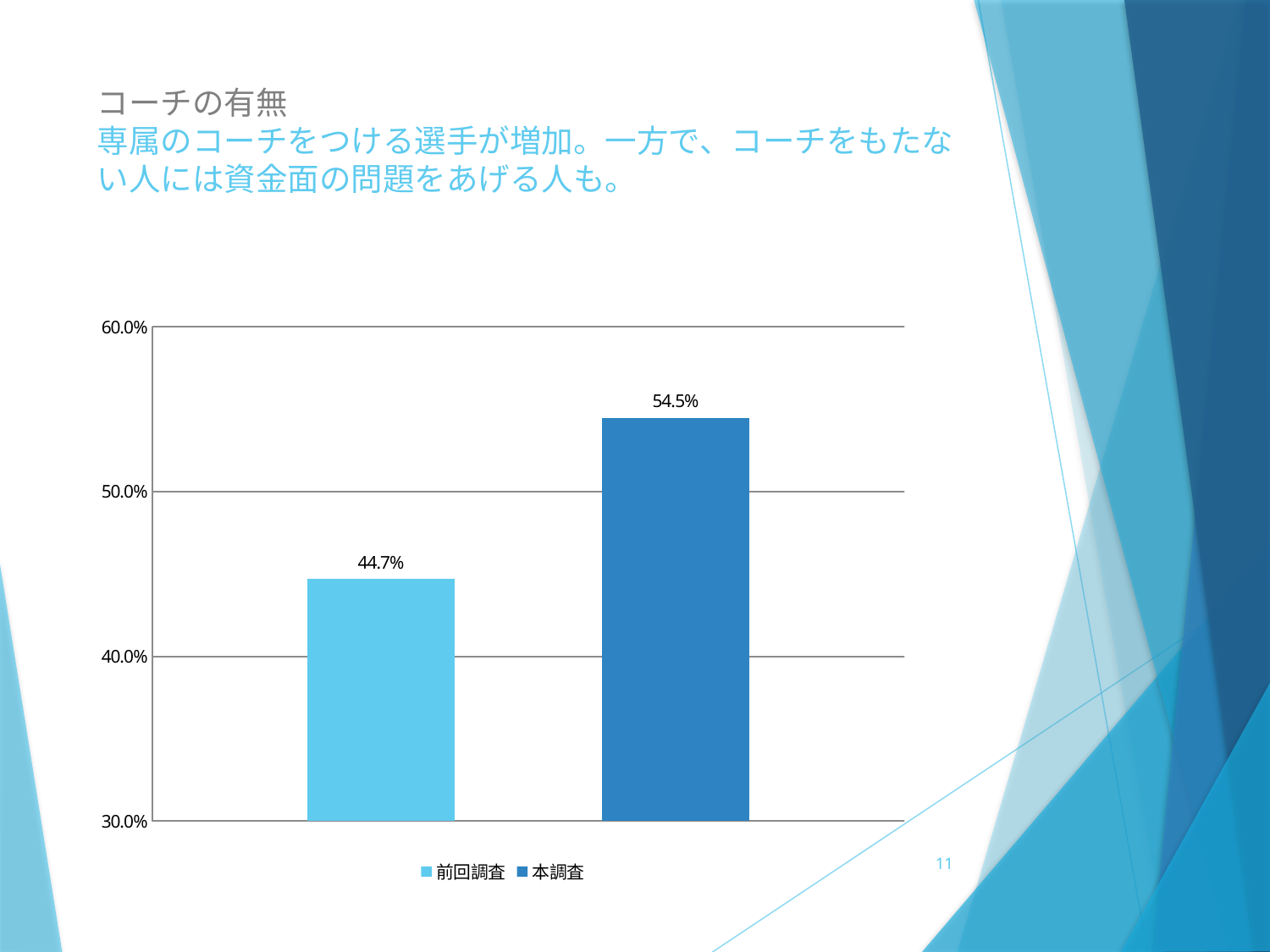
What kind of chart is shown on the slide? bar chart What is the value for 前回調査? 44.7% What is the lowest value shown on the vertical axis? 30.0% How many bars are plotted in the chart? 2 Is the value for 前回調査 greater or less than 50.0%? less Which series has the higher value, 前回調査 or 本調査? 本調査 Which series has the lowest value? 前回調査 What is the difference between the values for 本調査 and 前回調査? 9.8% What is the value for 本調査? 54.5% Is the value for 本調査 greater or less than 50.0%? greater What are the two legend entries of the chart? 前回調査, 本調査 How many series does the legend list? 2